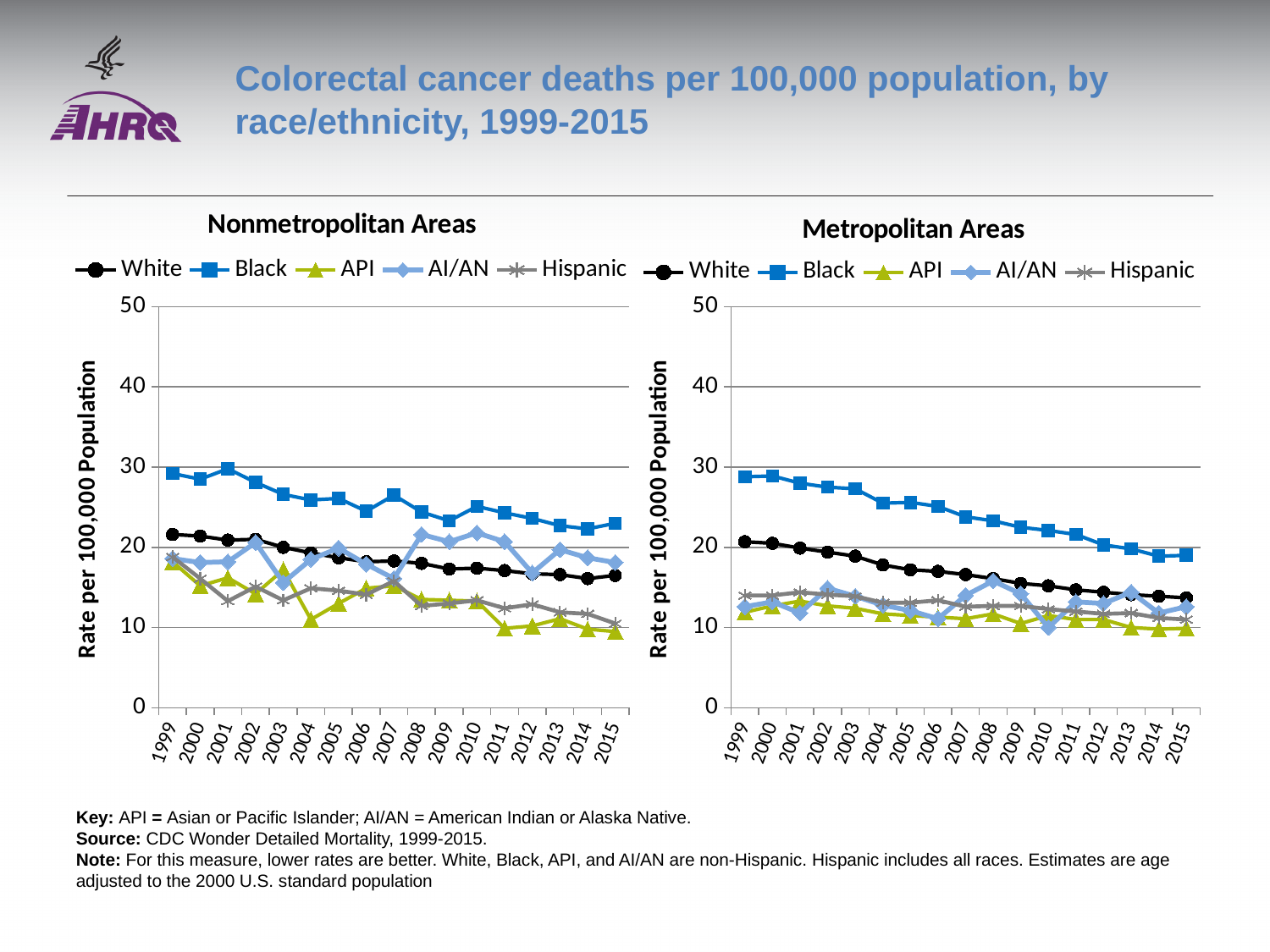
What is the y-axis label on the Metropolitan Areas chart? Rate per 100,000 Population How many years are plotted along the x axis of the Nonmetropolitan Areas chart? 17 In the Metropolitan Areas chart, is the value for White in 2015 greater or less than 20? less What kind of chart is the Nonmetropolitan Areas chart? Line chart In the Nonmetropolitan Areas chart, which is larger in 1999, the value for Black or the value for White? Black In the Metropolitan Areas chart, which race/ethnicity has the highest rate in 2015? Black In the Nonmetropolitan Areas chart, does the White series rise or fall from 1999 to 2015? Fall In the Metropolitan Areas chart, does the Black series rise or fall from 1999 to 2015? Fall In the Nonmetropolitan Areas chart, is the value for Black in 1999 greater or less than 20? greater How many series does the legend of the Metropolitan Areas chart list? 5 In the Nonmetropolitan Areas chart, which race/ethnicity has the highest rate in 1999? Black In the Metropolitan Areas chart, is the value for Black in 1999 greater or less than 30? less